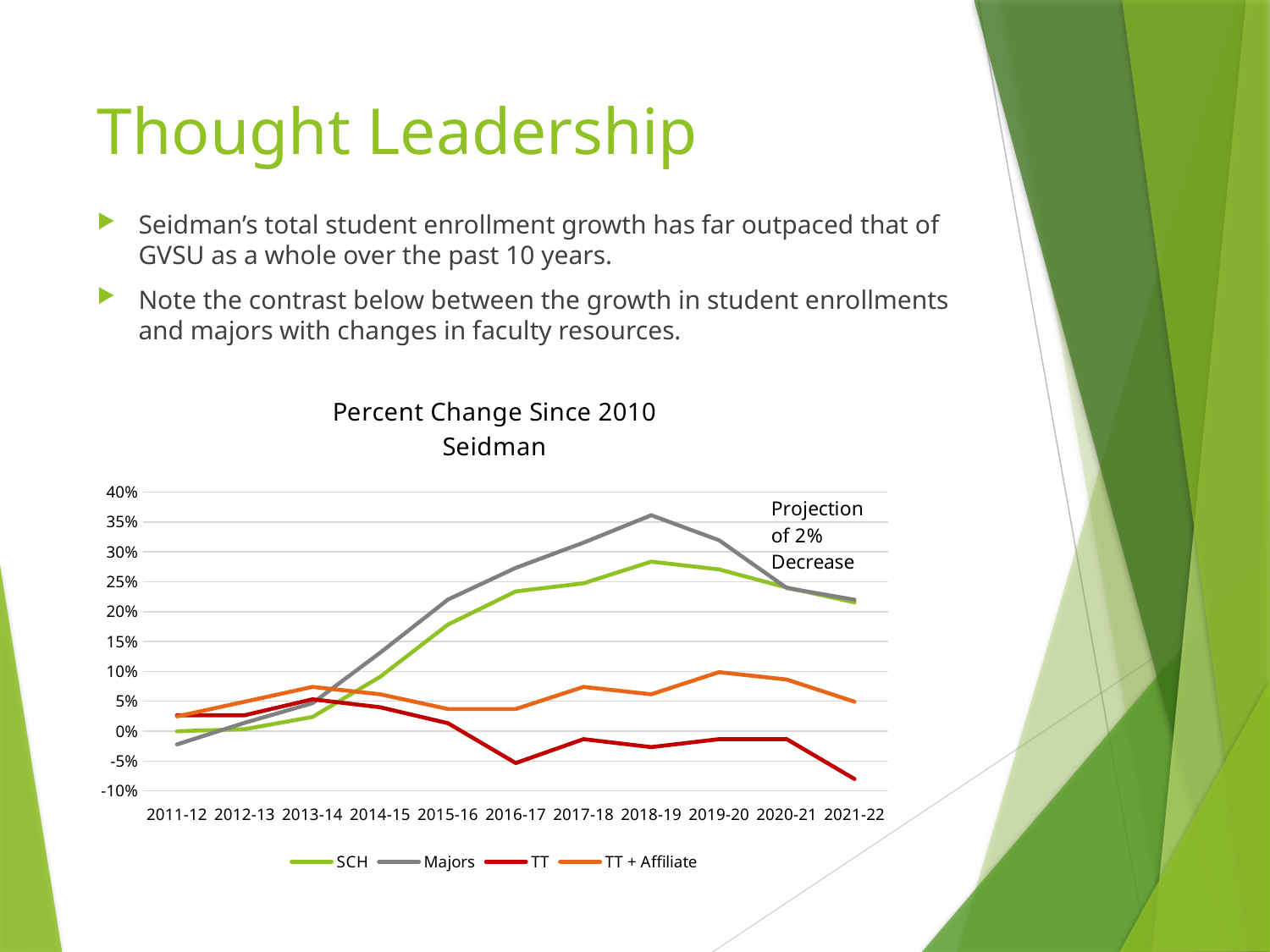
Is the value for TT in 2021-22 greater or less than -5%? less How many academic years are shown along the x axis of the chart? 11 In which academic year does the Majors series reach its highest value? 2018-19 In 2015-16, which series has the larger value, Majors or SCH? Majors What is the title of the chart? Percent Change Since 2010 Seidman Is the value for SCH in 2016-17 greater or less than 20%? greater Is the value for Majors in 2018-19 greater or less than 30%? greater In 2019-20, which series has the larger value, TT or TT + Affiliate? TT + Affiliate How many series does the chart legend list? 4 In which academic year does the TT series reach its lowest value? 2021-22 Does the Majors series rise or fall from 2011-12 to 2018-19? rise What kind of chart is shown on the slide? line chart